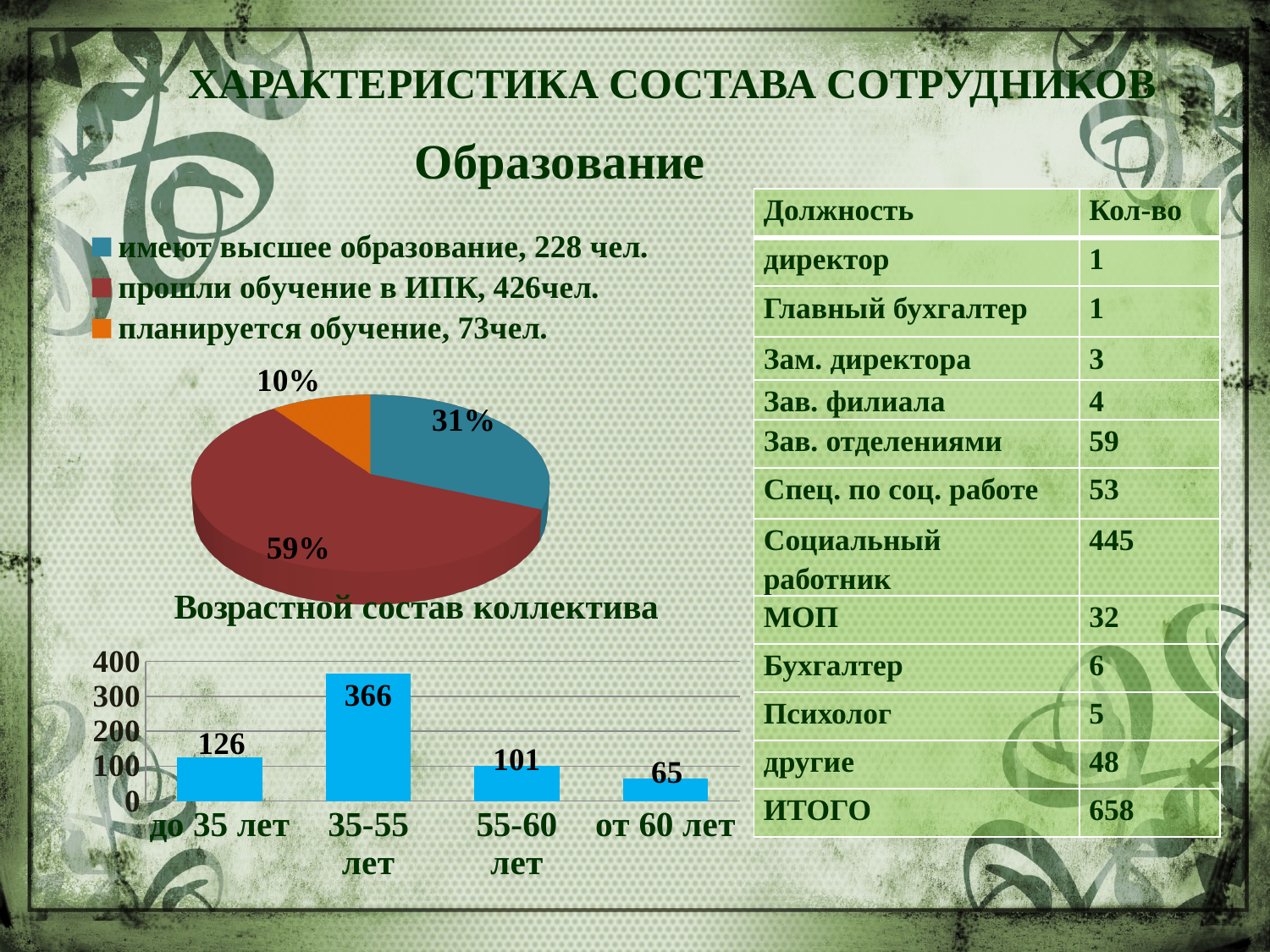
In the chart "Возрастной состав коллектива", what is the value for "35-55 лет"? 366 In the pie chart under "Образование", which legend entry has the largest slice? прошли обучение в ИПК, 426чел. What kind of chart is "Возрастной состав коллектива"? Bar chart In the chart "Возрастной состав коллектива", which age group has the lowest value? от 60 лет In the pie chart under "Образование", what colour is the slice for "планируется обучение"? Orange In the pie chart under "Образование", what share is labelled for "прошли обучение в ИПК"? 59% In the chart "Возрастной состав коллектива", what is the value for "от 60 лет"? 65 In the chart "Возрастной состав коллектива", how many age categories are shown? 4 In the chart "Возрастной состав коллектива", what is the difference between the values for "до 35 лет" and "55-60 лет"? 25 In the pie chart under "Образование", what share is labelled for "планируется обучение"? 10% In the pie chart under "Образование", what share is labelled for "имеют высшее образование"? 31% In the pie chart under "Образование", how many entries does the legend list? 3